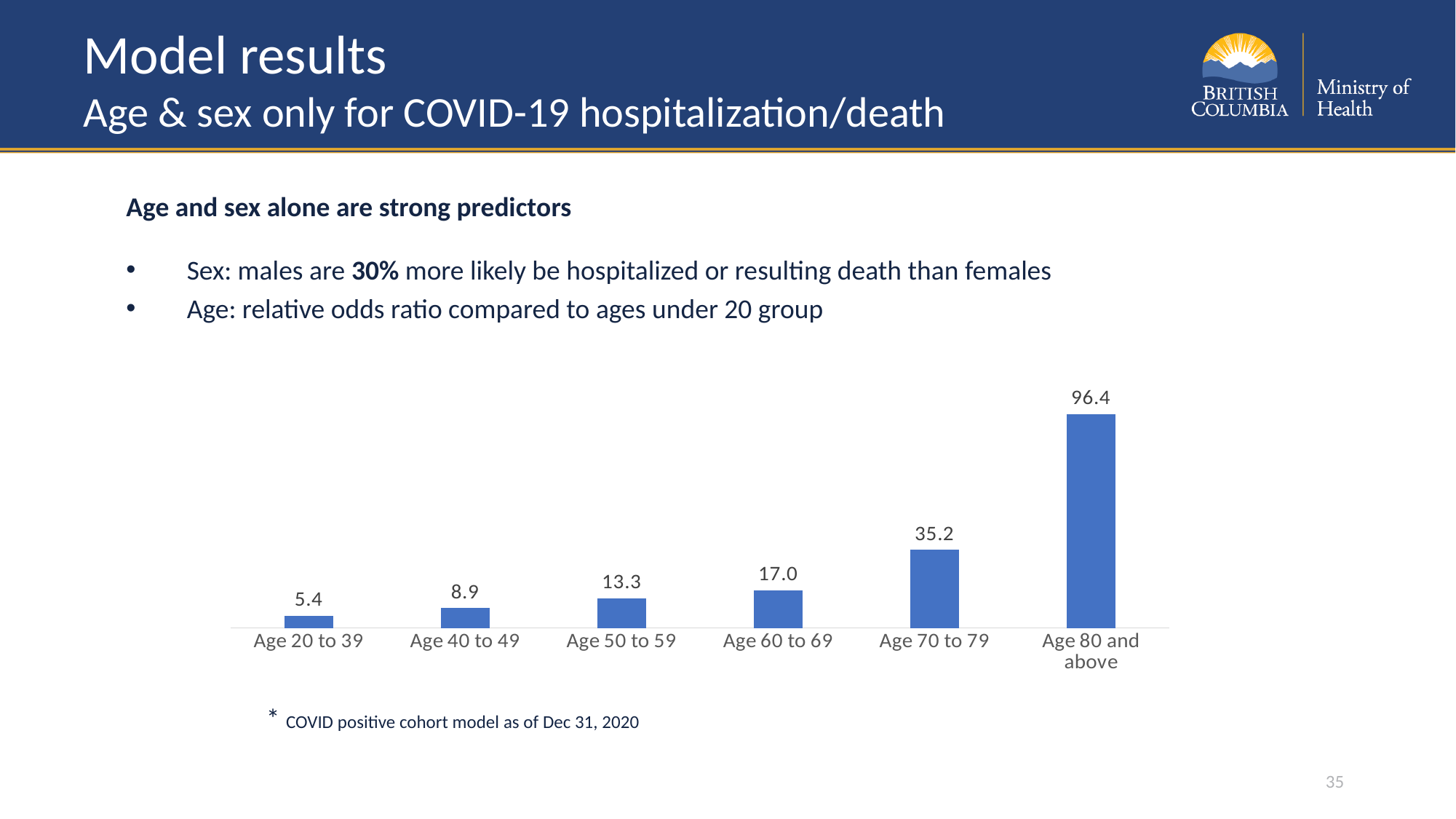
What kind of chart is shown on the slide? Bar chart What is the relative odds ratio for Age 20 to 39? 5.4 Which is larger, the value for Age 60 to 69 or Age 50 to 59? Age 60 to 69 What is the value shown for Age 60 to 69? 17.0 What is the difference between the values for Age 80 and above and Age 70 to 79? 61.2 What is the value shown for Age 70 to 79? 35.2 Do the values rise or fall as age increases along the x axis? Rise What is the difference between the values for Age 50 to 59 and Age 40 to 49? 4.4 What colour are the bars in the chart? Blue Which age group has the highest value? Age 80 and above How many age groups are shown in the chart? 6 Which age group has the lowest value? Age 20 to 39